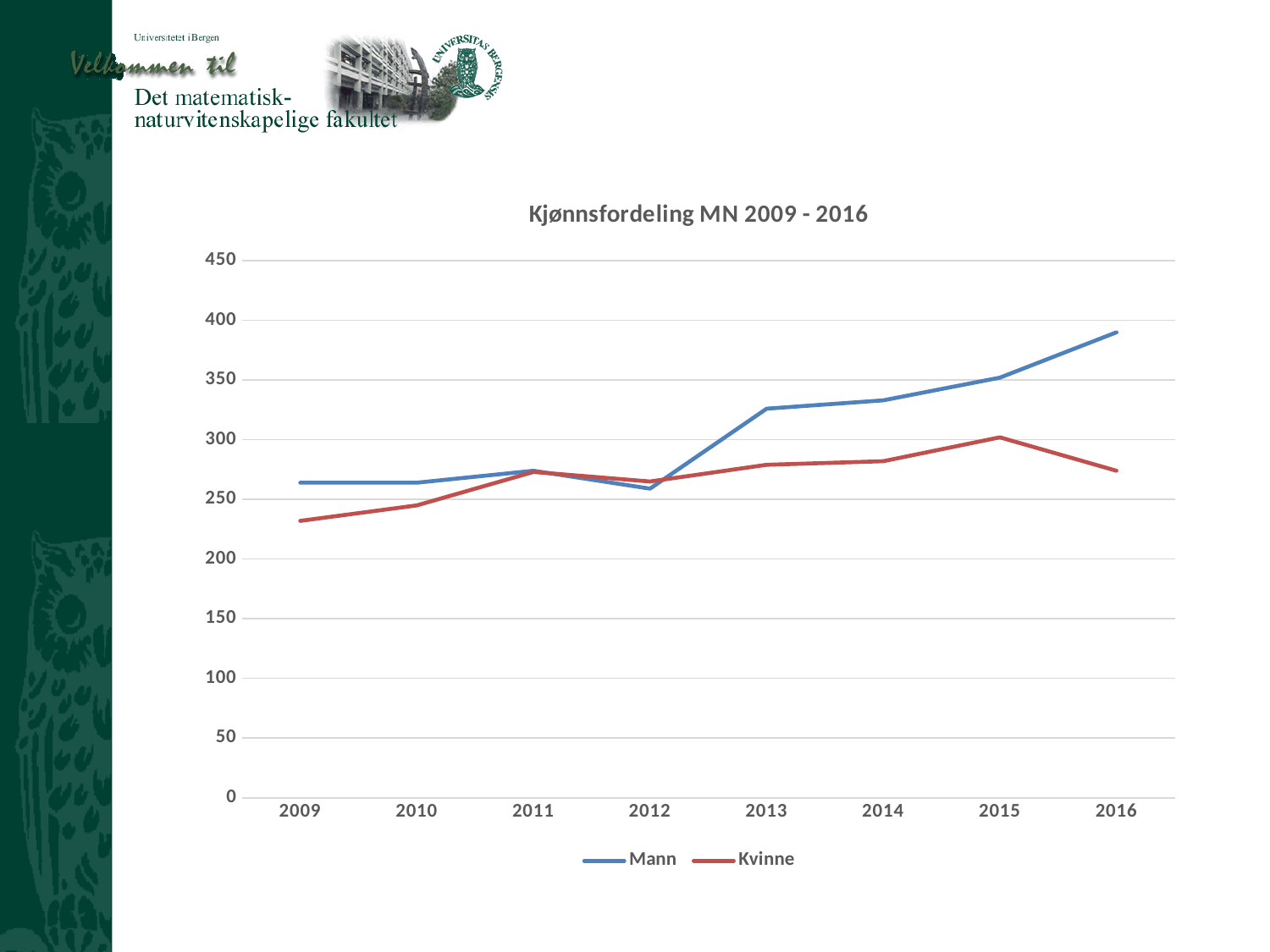
Is the value for Mann in 2013 greater or less than 300? greater Which series has the higher value in 2016, Mann or Kvinne? Mann Is the value for Kvinne in 2009 greater or less than 250? less In which year does the Mann series reach its highest value? 2016 How many years are plotted along the x axis? 8 What is the title of the chart? Kjønnsfordeling MN 2009 - 2016 What kind of chart is shown on the slide? line chart Is the value for Mann in 2016 greater or less than 400? less How many series does the legend list? 2 Which colour is used for the Kvinne series? red In which year does the Kvinne series have its lowest value? 2009